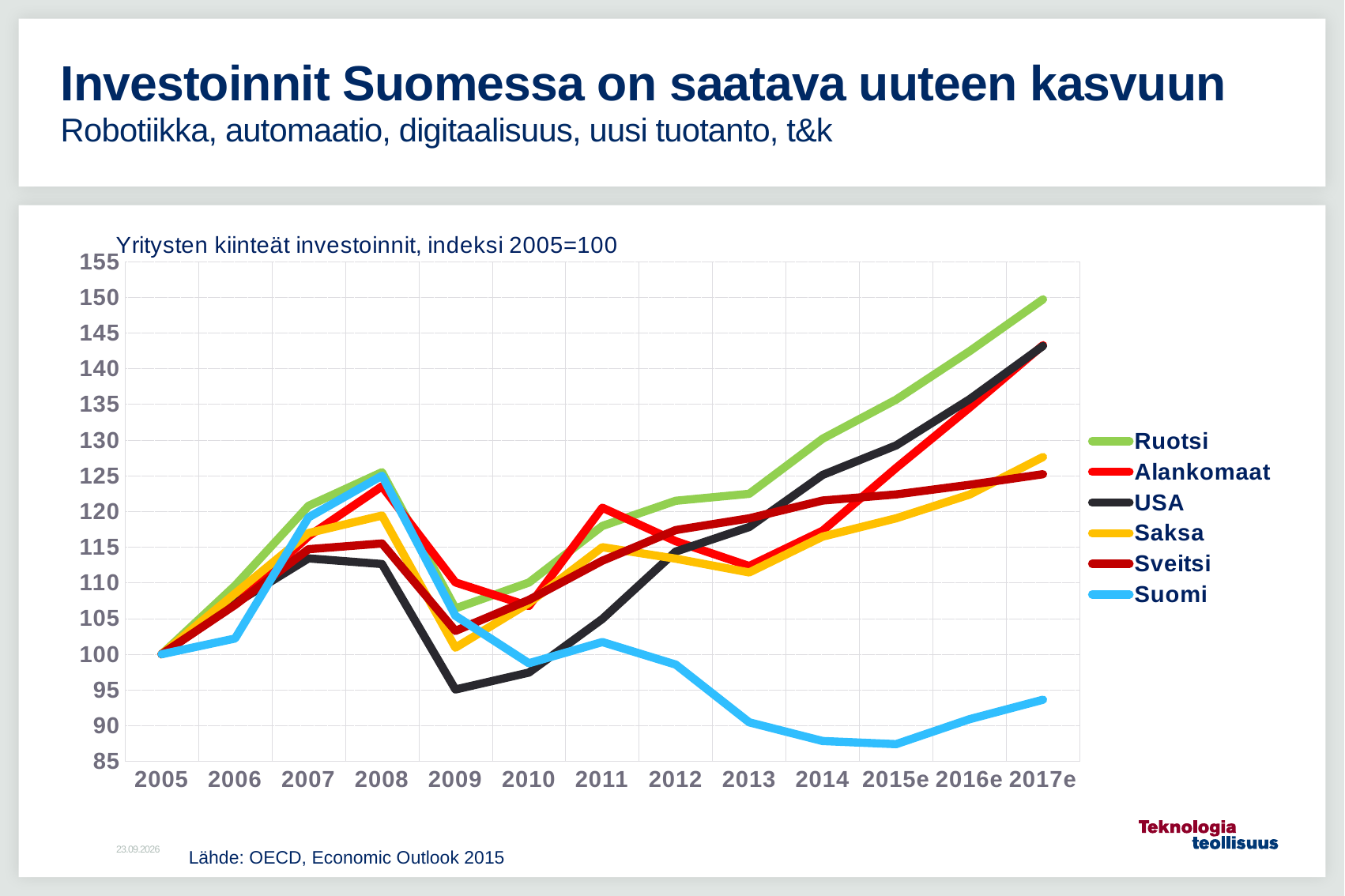
Which series has the highest value in 2017e? Ruotsi Is the value for USA in 2009 greater or less than 100? less What is the title of the chart? Yritysten kiinteät investoinnit, indeksi 2005=100 Is the value for Ruotsi in 2017e greater or less than 145? greater How many years are shown on the x axis? 13 What is the index value for Suomi in 2005? 100 What kind of chart is shown on the slide? line chart How many series does the legend list? 6 Is the value for Suomi in 2017e greater or less than 95? less Does the value for Suomi rise or fall from 2011 to 2015e? fall Which series has the lowest value in 2017e? Suomi Which is larger in 2014, the value for Ruotsi or the value for Suomi? Ruotsi